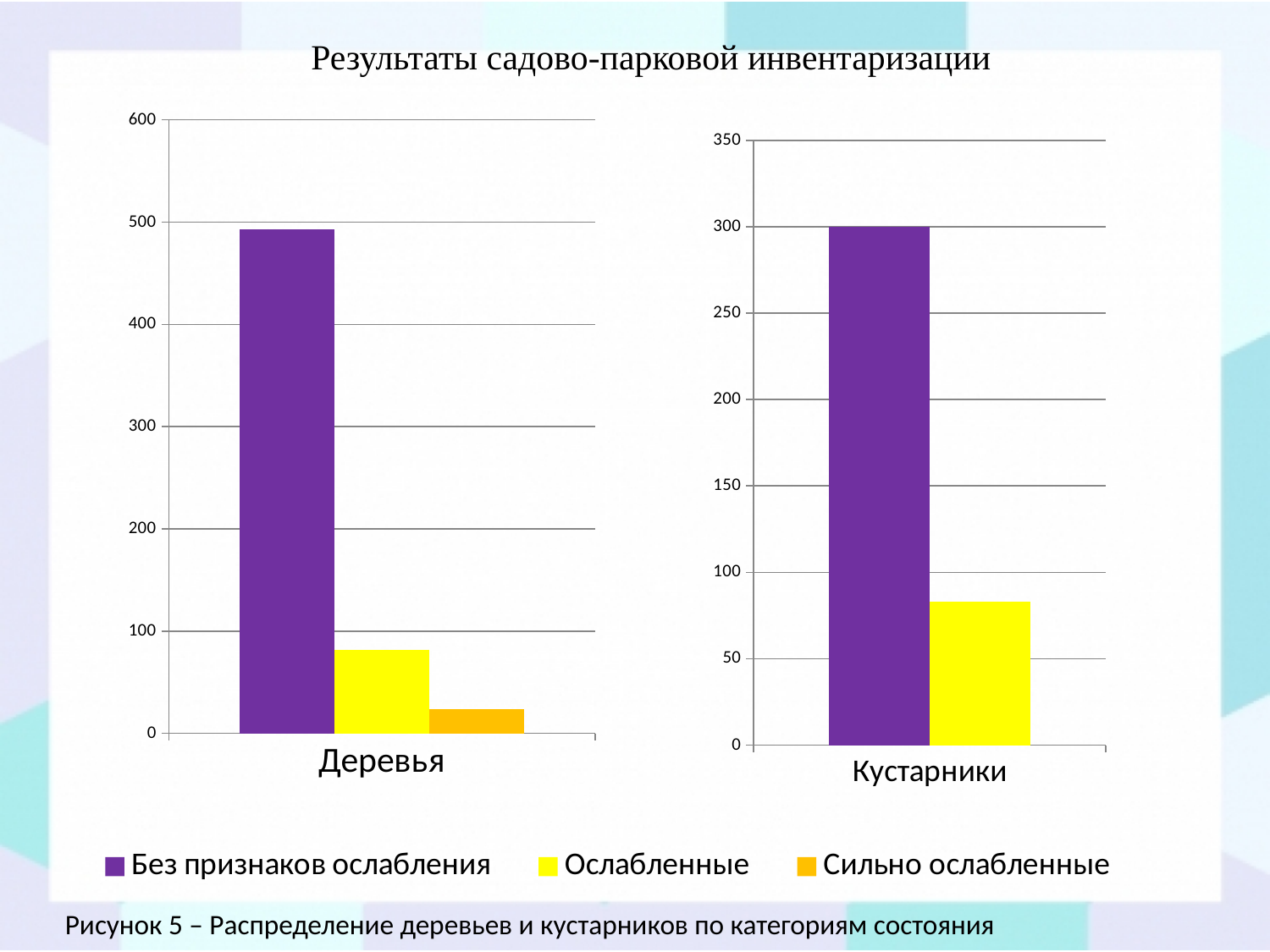
In the Деревья chart, is the value for Без признаков ослабления greater or less than 400? greater What kind of chart is the left chart labelled Деревья? bar chart In the Деревья chart, which series has the highest value? Без признаков ослабления In the Деревья chart, is the value for Сильно ослабленные greater or less than 100? less In the Кустарники chart, is the value for Ослабленные greater or less than 100? less In the Кустарники chart, what is the value for Без признаков ослабления? 300 What is the title of the slide above the charts? Результаты садово-парковой инвентаризации How many bars are plotted in the Кустарники chart? 2 In the Деревья chart, which series has the lowest value? Сильно ослабленные In the Кустарники chart, which is larger: Без признаков ослабления or Ослабленные? Без признаков ослабления How many series does the legend list? 3